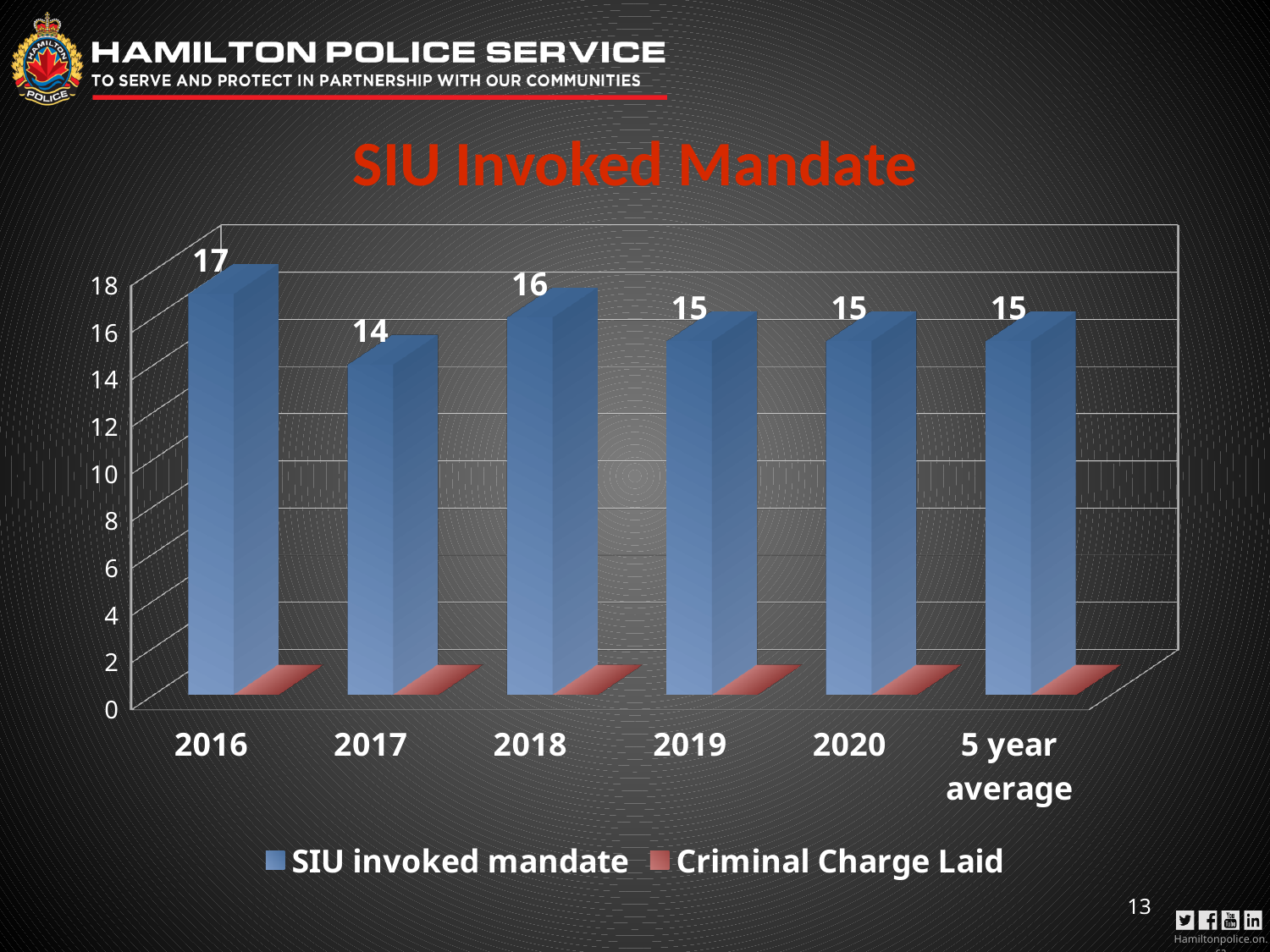
Which is larger, the SIU invoked mandate value for 2018 or for 2019? 2018 How many categories are shown on the x axis? 6 What is the title of the chart? SIU Invoked Mandate What is the 5 year average value for SIU invoked mandate? 15 What is the difference between the SIU invoked mandate values for 2016 and 2017? 3 Which year has the lowest SIU invoked mandate value? 2017 How many series does the legend list? 2 Which year has the highest SIU invoked mandate value? 2016 What is the value of SIU invoked mandate for 2016? 17 What kind of chart is shown on the slide? Bar chart What is the value of SIU invoked mandate for 2017? 14 What is the value of SIU invoked mandate for 2018? 16